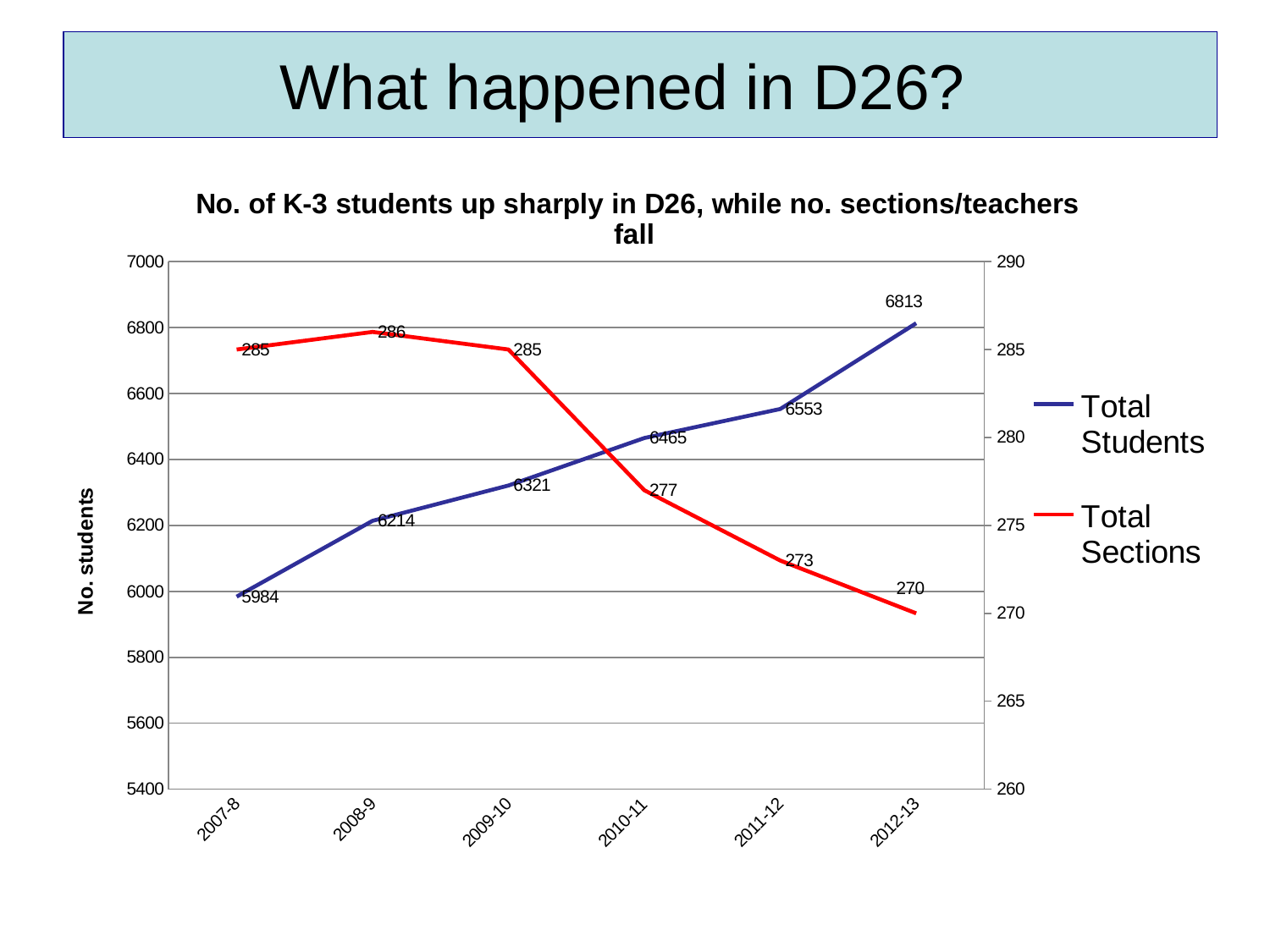
Does the Total Sections series rise or fall from 2009-10 to 2012-13? Fall By how much did Total Students increase from 2007-8 to 2012-13? 829 What was the Total Sections value in 2010-11? 277 How many series does the legend list? 2 Which year had more Total Students, 2009-10 or 2011-12? 2011-12 What kind of chart is shown on the slide? Line chart What was the Total Students value in 2012-13? 6813 What was the Total Students value in 2007-8? 5984 In which year was Total Sections highest? 2008-9 In which year was Total Students lowest? 2007-8 What is the difference in Total Sections between 2008-9 and 2012-13? 16 How many years are shown on the x axis? 6